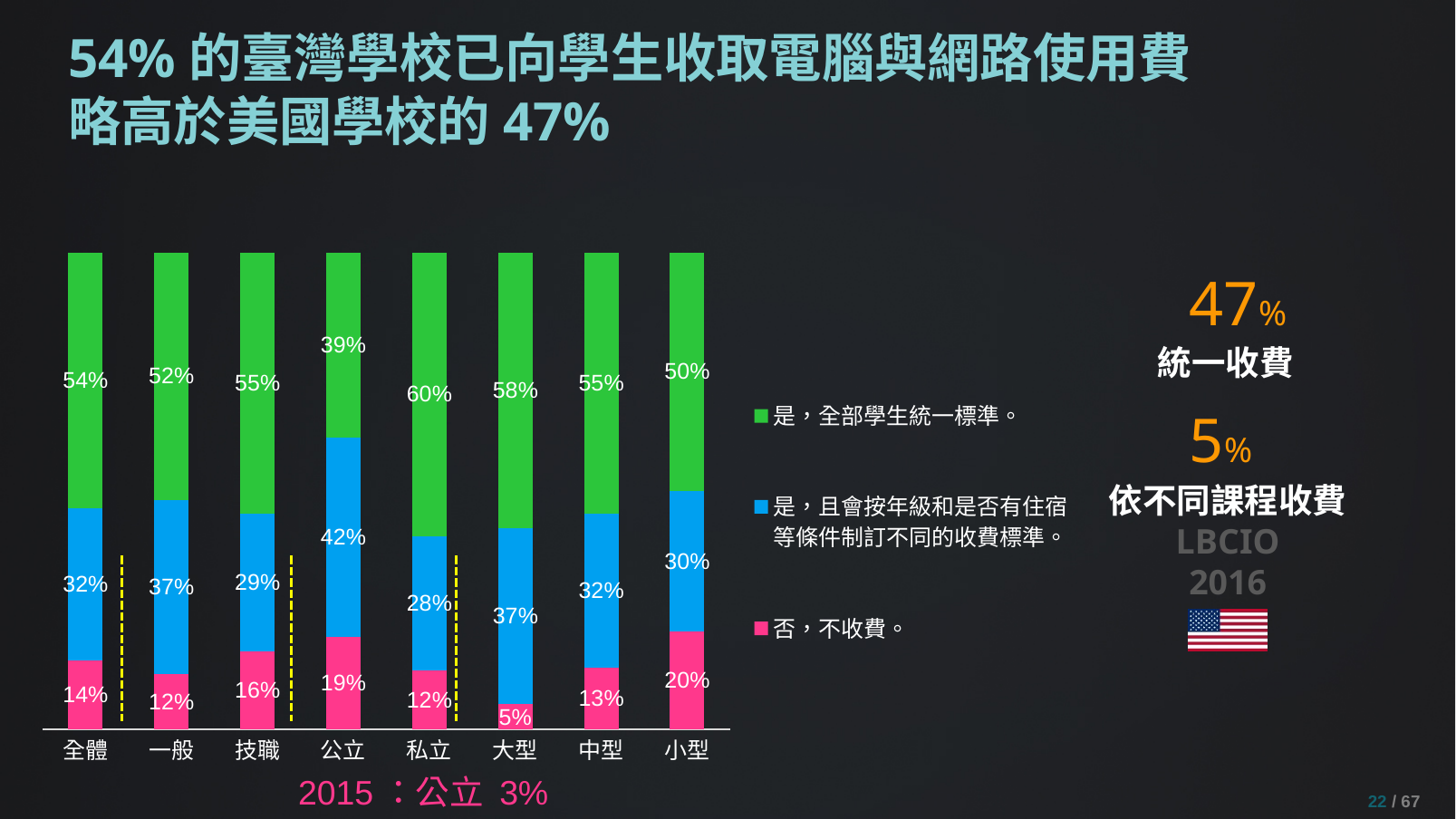
How many categories are shown along the x axis of the chart? 8 Which category has the highest value for the green series (是，全部學生統一標準。)? 私立 Which category has the lowest value for the pink series (否，不收費。)? 大型 Which series in the legend is shown in pink? 否，不收費。 What is the difference between the green series values for 私立 and 公立? 21% How many series does the chart's legend list? 3 What is the value of the pink series (否，不收費。) for 大型? 5% What is the value of the blue series (是，且會按年級和是否有住宿等條件制訂不同的收費標準。) for 公立? 42% What kind of chart is shown on the slide? stacked bar chart What is the value of the green series (是，全部學生統一標準。) for 私立? 60% Which is larger: the blue series value for 一般 or for 技職? 一般 What is the total of the stacked bar for 小型? 100%